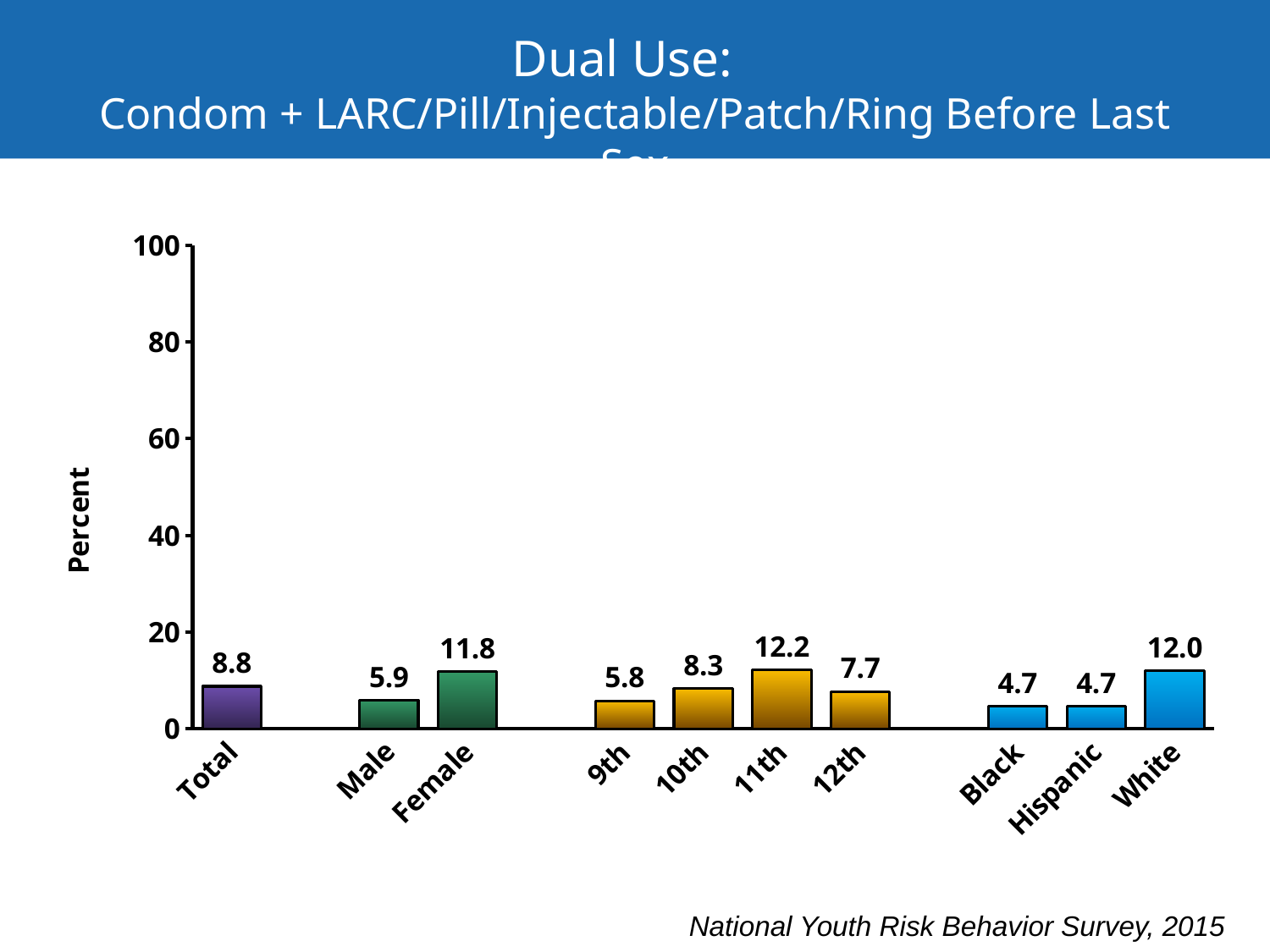
What is the label of the y axis? Percent Which is larger, the value for 10th or the value for 12th? 10th What is the value for Female? 11.8 Is the value for White greater or less than 20? less What is the value for Total? 8.8 How many categories are shown on the x axis? 10 Which category has the lowest value? Black and Hispanic (both 4.7) What kind of chart is this? bar chart What is the value for 11th? 12.2 What is the difference between the Female and Male values? 5.9 Which grade has the highest value? 11th What is the value for Hispanic? 4.7